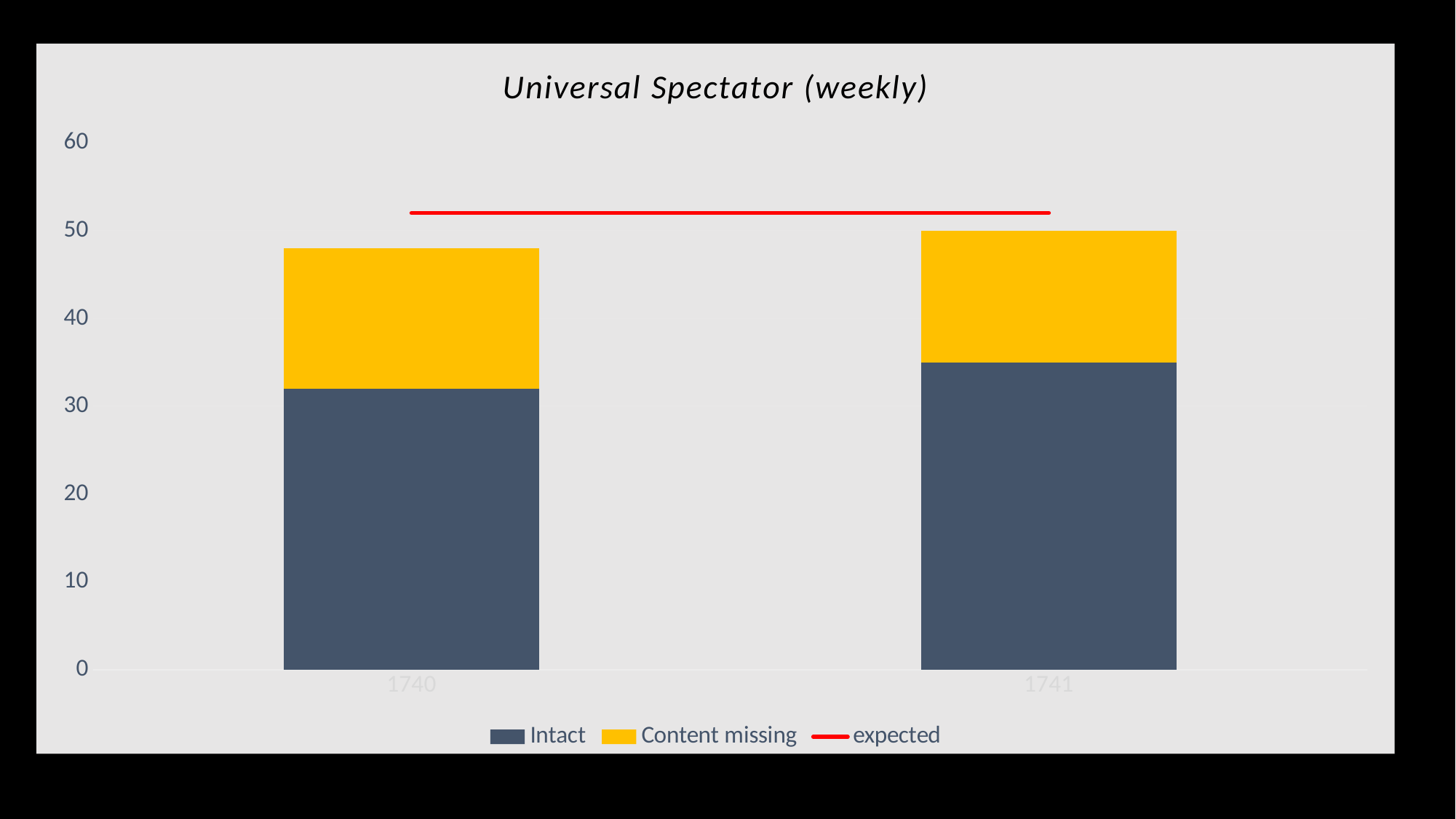
Which colour represents the Intact series? dark blue-grey What kind of chart is shown on the slide? stacked bar chart with a line (combination bar and line chart) Which year has the larger Intact value, 1740 or 1741? 1741 How many series does the legend list? 3 Is the Intact value for 1740 greater or less than 30? greater Is the expected line greater or less than 50? greater How many categories are shown on the x axis? 2 What is the title of the chart? Universal Spectator (weekly) Which year has the taller total stacked bar? 1741 Do the total stacked bars rise or fall from 1740 to 1741? rise Is the total stacked bar for 1740 greater or less than 50? less